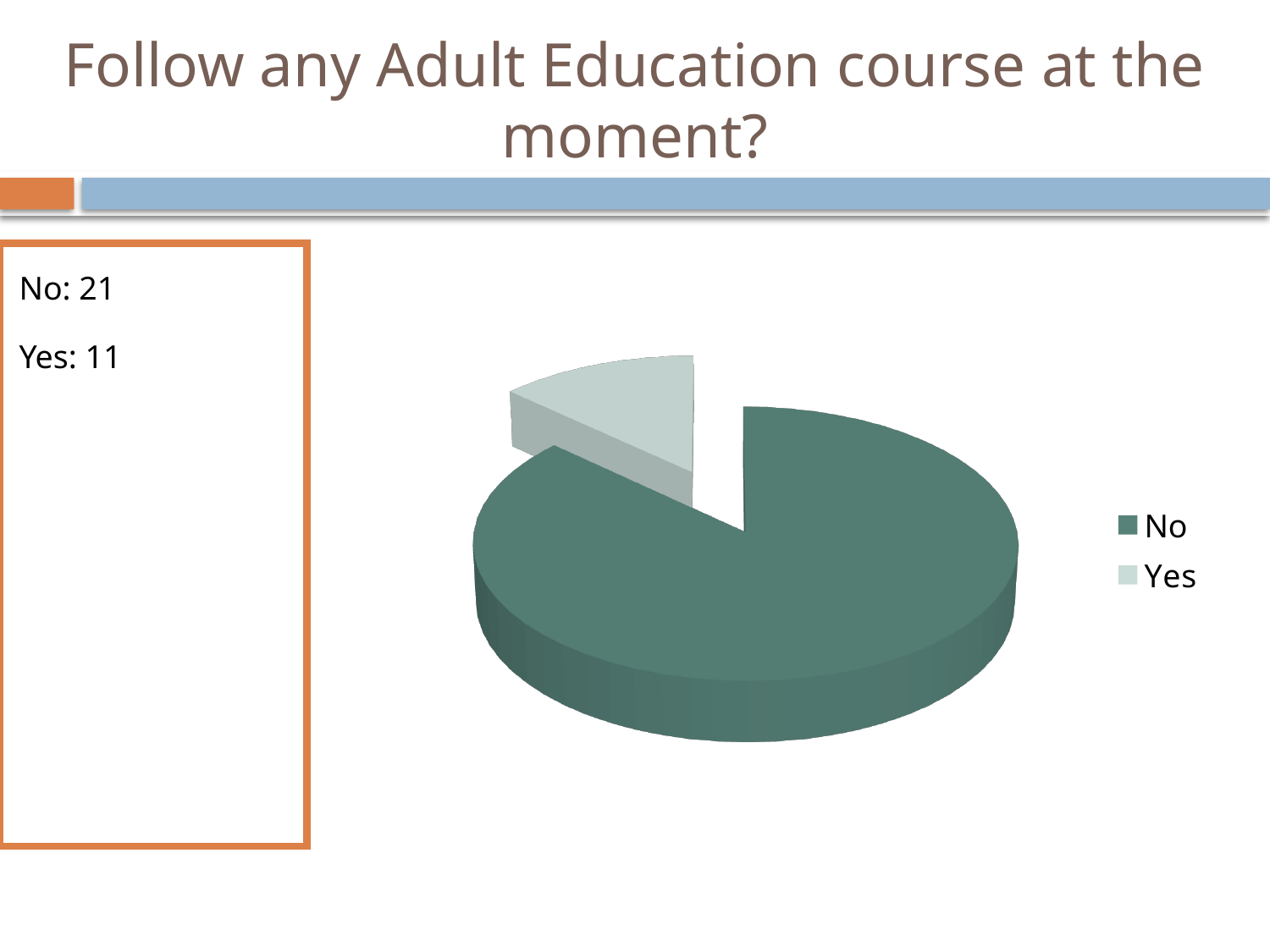
What is the difference between the value for No and the value for Yes? 10 What is the value for No? 21 How many slices does the pie chart have? 2 Which category has the largest slice of the pie chart? No What are the two categories listed in the legend of the pie chart? No and Yes What is the total of the values for No and Yes? 32 Which is larger, the value for No or the value for Yes? No What type of chart is shown on the slide? pie chart What is the title of the slide containing the pie chart? Follow any Adult Education course at the moment? Which category has the smallest slice of the pie chart? Yes Which colour represents the Yes slice in the pie chart? light grey-green What is the value for Yes? 11